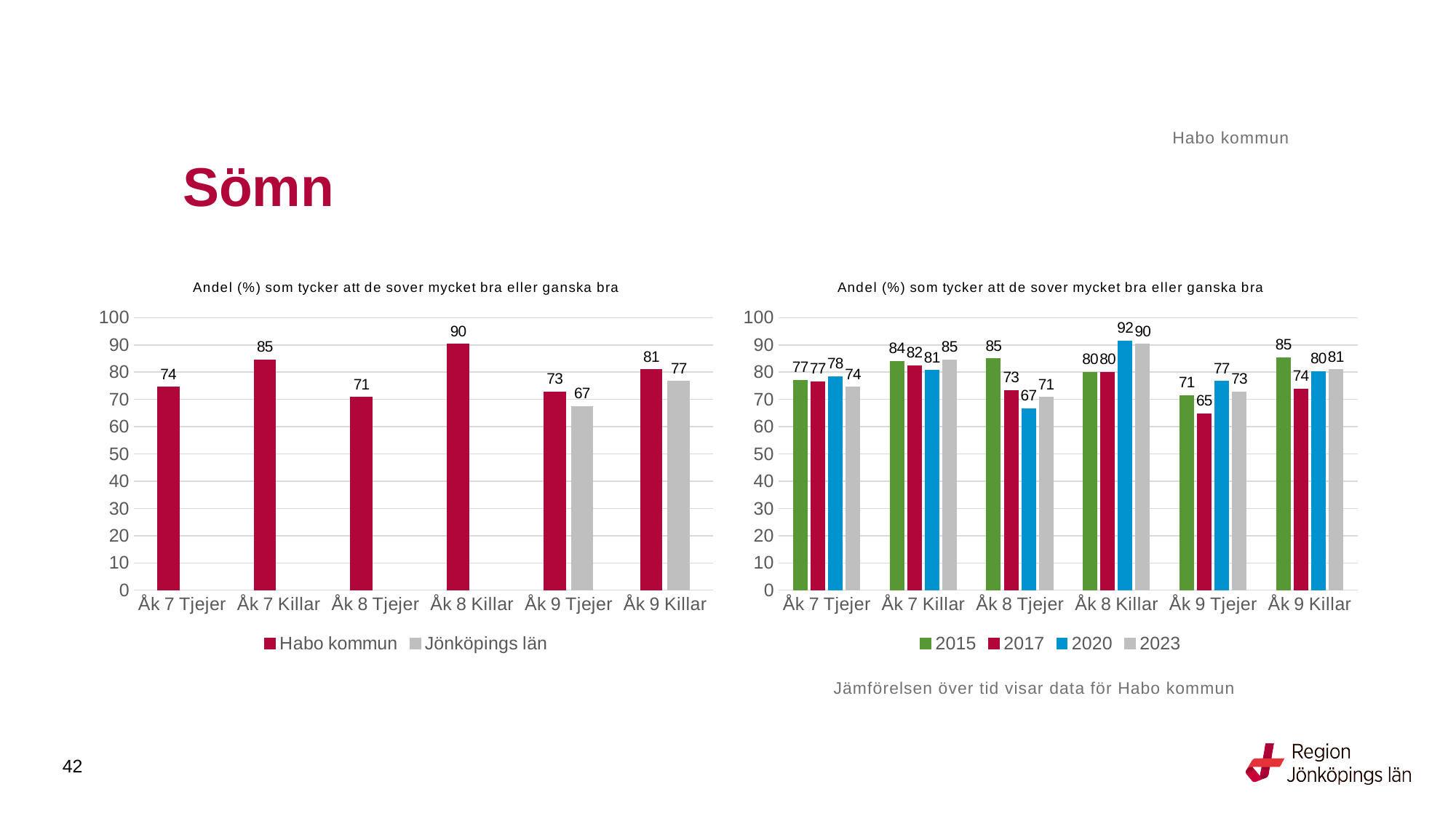
In the left chart, how many series does the legend list? 2 In the left chart, what is the value for Jönköpings län for Åk 9 Tjejer? 67 In the right chart, how many series does the legend list? 4 In the left chart, what is the value for Habo kommun for Åk 8 Killar? 90 In the right chart, which is larger for Åk 9 Killar: 2015 or 2017? 2015 In the right chart, what is the difference between the 2020 and 2017 values for Åk 9 Tjejer? 12 In the right chart, what is the value for 2017 for Åk 9 Tjejer? 65 In the right chart, what is the value for 2020 for Åk 8 Killar? 92 In the left chart, which category has the lowest value for Habo kommun? Åk 8 Tjejer In the left chart, what is the difference between Habo kommun and Jönköpings län for Åk 9 Killar? 4 In the right chart, which year has the highest value for Åk 8 Tjejer? 2015 What kind of chart is the left chart? Bar chart